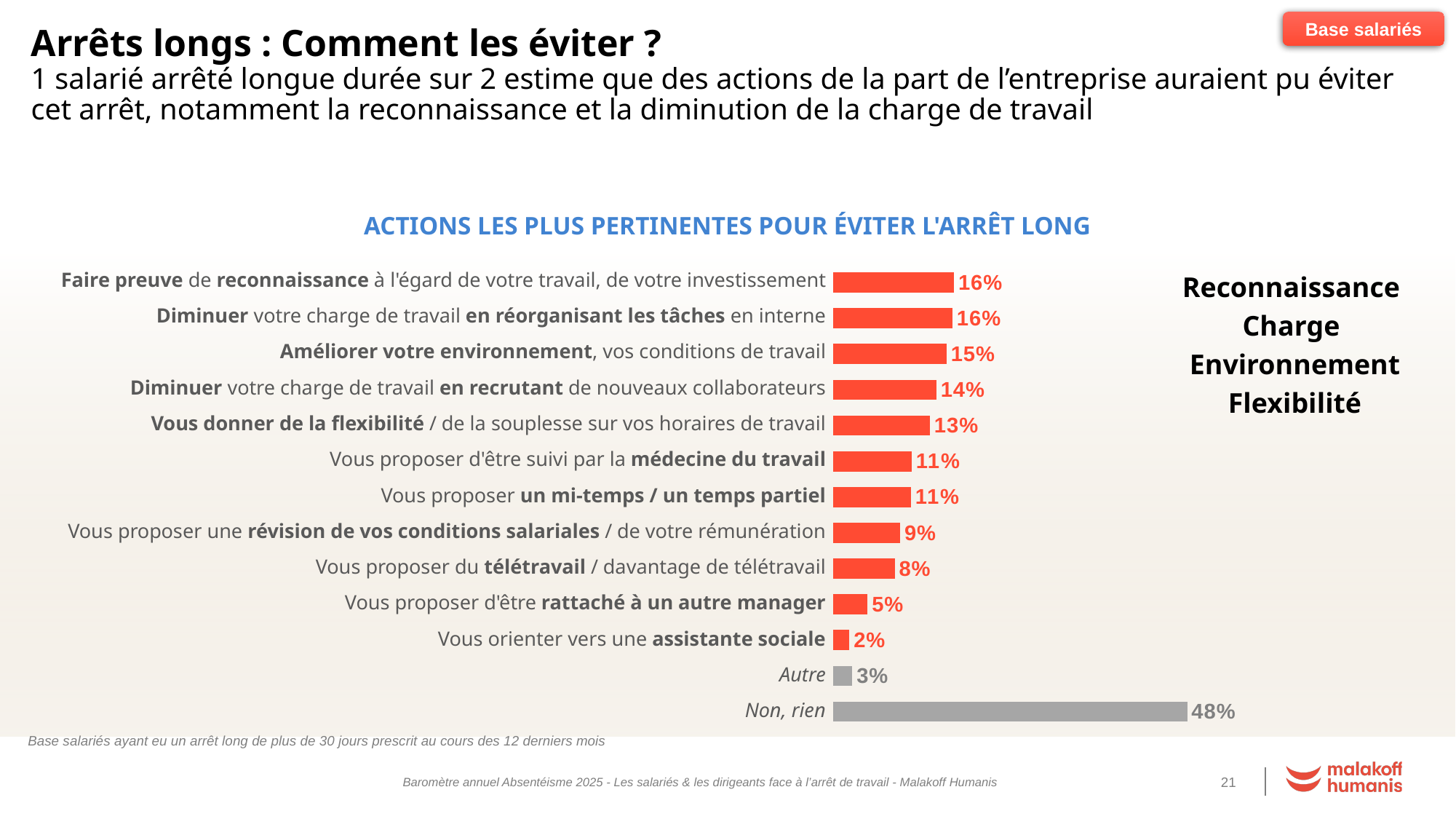
Which category has the lowest value in the chart? Vous orienter vers une assistante sociale What percentage is shown for "Non, rien"? 48% What type of chart is shown on the slide? Bar chart Which is larger: the value for "Diminuer votre charge de travail en recrutant de nouveaux collaborateurs" or the value for "Vous proposer d'être suivi par la médecine du travail"? Diminuer votre charge de travail en recrutant de nouveaux collaborateurs What is the value for "Vous proposer d'être rattaché à un autre manager"? 5% What is the difference between the value for "Non, rien" and the value for "Faire preuve de reconnaissance à l'égard de votre travail, de votre investissement"? 32 percentage points What is the value for "Vous donner de la flexibilité / de la souplesse sur vos horaires de travail"? 13% What is the title of the chart? ACTIONS LES PLUS PERTINENTES POUR ÉVITER L'ARRÊT LONG What is the value for "Vous proposer du télétravail / davantage de télétravail"? 8% Which category has the highest value in the chart? Non, rien What is the difference between "Améliorer votre environnement, vos conditions de travail" and "Vous proposer une révision de vos conditions salariales / de votre rémunération"? 6 percentage points How many categories are plotted in the chart? 13